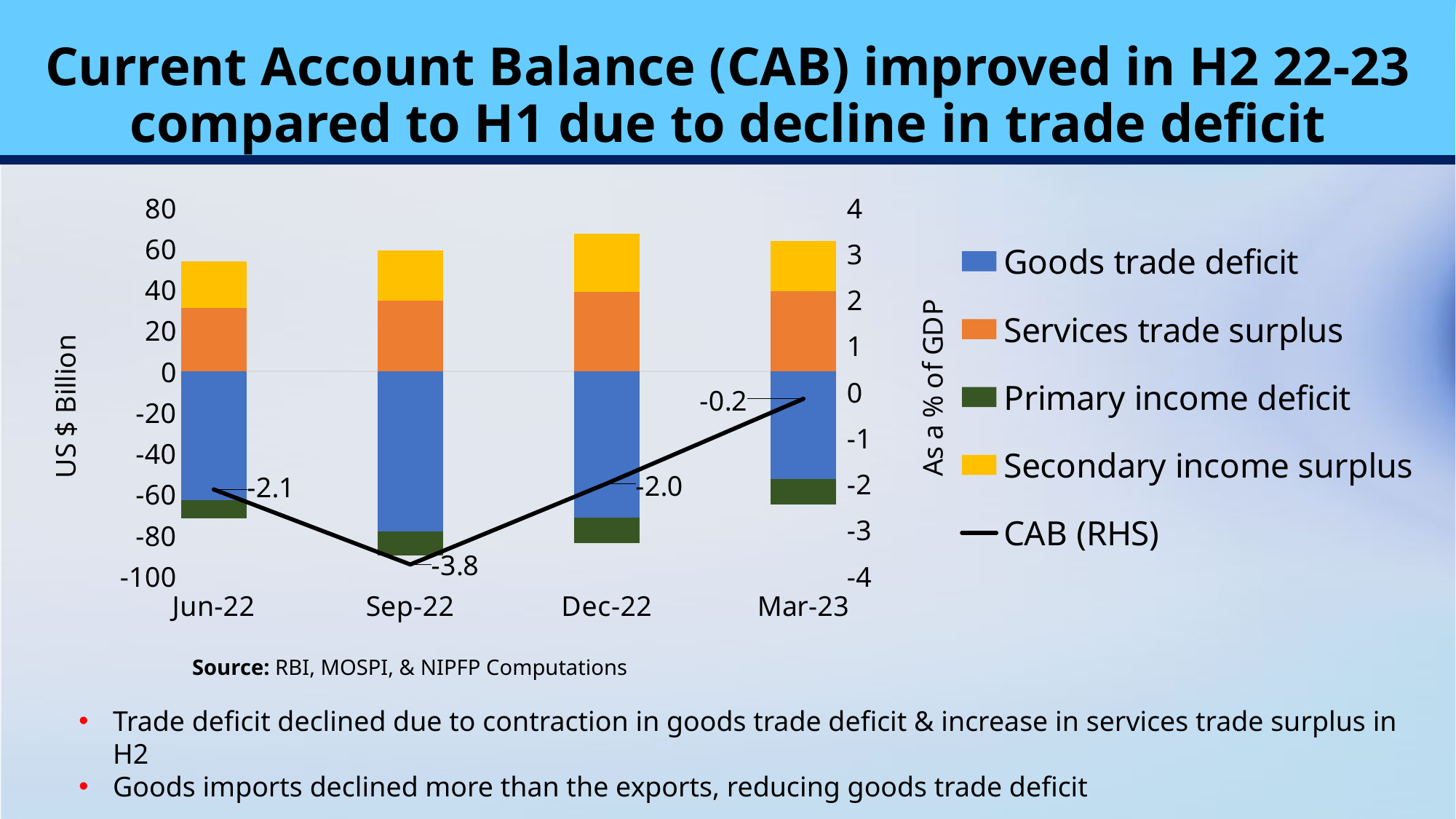
Does the CAB (RHS) line rise or fall from Sep-22 to Mar-23? rise What is the CAB (RHS) value for Jun-22? -2.1 In which quarter is the CAB (RHS) value highest? Mar-23 What is the CAB (RHS) value for Sep-22? -3.8 What is the CAB (RHS) value for Mar-23? -0.2 In which quarter is the CAB (RHS) value lowest? Sep-22 Is the Goods trade deficit value for Sep-22 greater or less than -60? less Which quarter has the larger CAB (RHS) value, Jun-22 or Dec-22? Dec-22 By how much did the CAB (RHS) value change from Sep-22 to Mar-23? 3.6 How many series does the legend list? 5 What is the label of the left vertical axis? US $ Billion How many quarters are shown on the x axis? 4